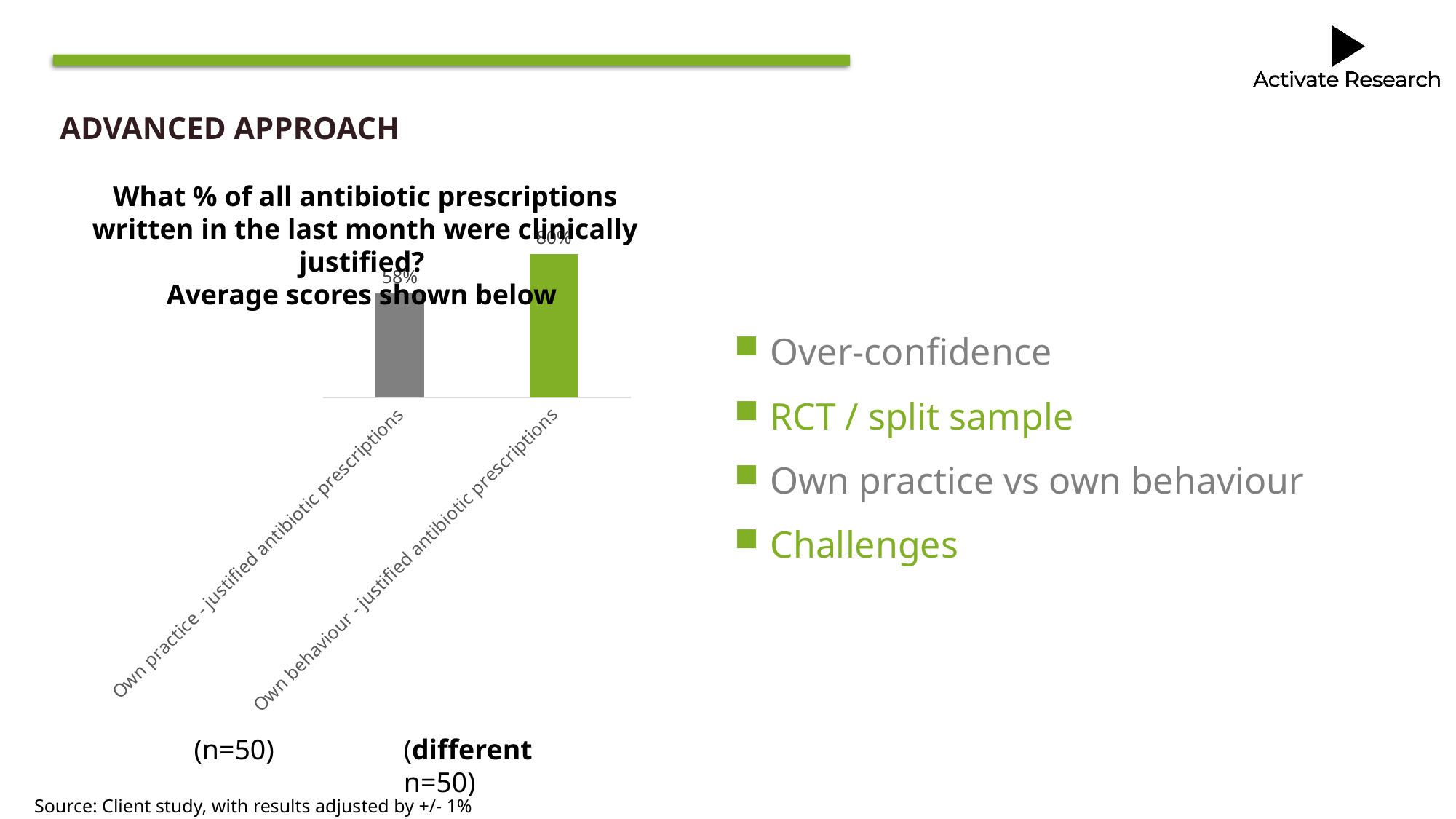
What is the sample size (n) shown under each bar? n=50 How many bars (categories) does the chart show? 2 Is the value for 'Own behaviour' larger or smaller than the value for 'Own practice'? larger What is the value for 'Own behaviour - justified antibiotic prescriptions'? 80% What is the value for 'Own practice - justified antibiotic prescriptions'? 58% What is the difference between the 'Own behaviour' value and the 'Own practice' value? 22% What colour is the bar for 'Own behaviour - justified antibiotic prescriptions'? green What kind of chart is shown on the slide? bar chart Which category has the higher value? Own behaviour - justified antibiotic prescriptions What colour is the bar for 'Own practice - justified antibiotic prescriptions'? grey Which category has the lower value? Own practice - justified antibiotic prescriptions